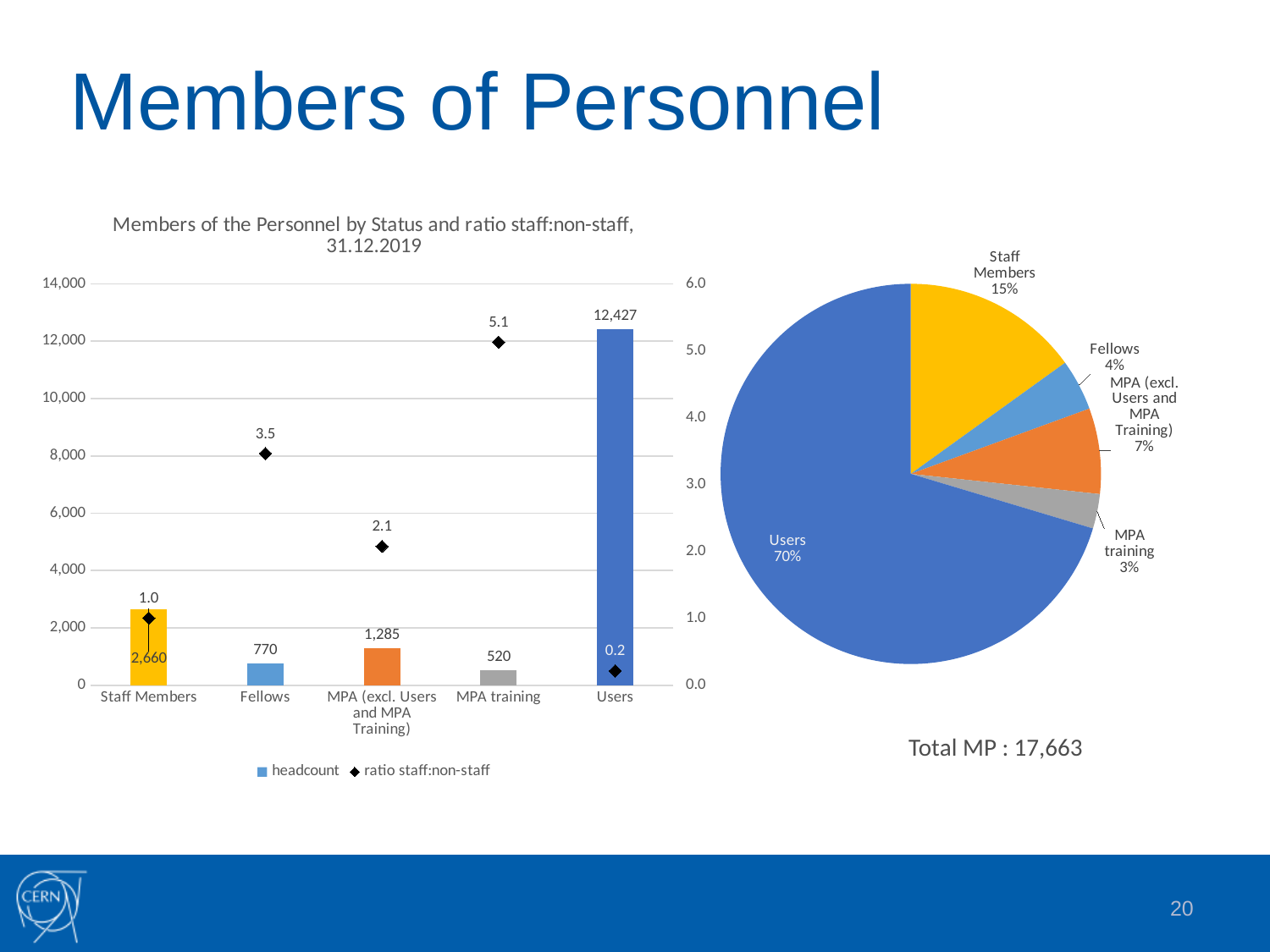
In the chart 'Members of the Personnel by Status and ratio staff:non-staff, 31.12.2019', which category has the highest ratio staff:non-staff? MPA training In the chart 'Members of the Personnel by Status and ratio staff:non-staff, 31.12.2019', how many series does the legend list? 2 In the chart 'Members of the Personnel by Status and ratio staff:non-staff, 31.12.2019', which has the larger headcount, Fellows or MPA training? Fellows In the pie chart on the right of the slide, what percentage is shown for Fellows? 4% In the chart 'Members of the Personnel by Status and ratio staff:non-staff, 31.12.2019', how many categories are shown on the x axis? 5 In the pie chart on the right of the slide, what share of the pie do Users represent? 70% In the chart 'Members of the Personnel by Status and ratio staff:non-staff, 31.12.2019', what kind of chart is used to show the headcount? bar chart In the chart 'Members of the Personnel by Status and ratio staff:non-staff, 31.12.2019', what is the headcount for Users? 12,427 In the chart 'Members of the Personnel by Status and ratio staff:non-staff, 31.12.2019', which category has the highest headcount? Users In the chart 'Members of the Personnel by Status and ratio staff:non-staff, 31.12.2019', what is the ratio staff:non-staff for Fellows? 3.5 In the chart 'Members of the Personnel by Status and ratio staff:non-staff, 31.12.2019', what is the difference between the headcount of Staff Members and Fellows? 1,890 In the chart 'Members of the Personnel by Status and ratio staff:non-staff, 31.12.2019', which category has the lowest headcount? MPA training